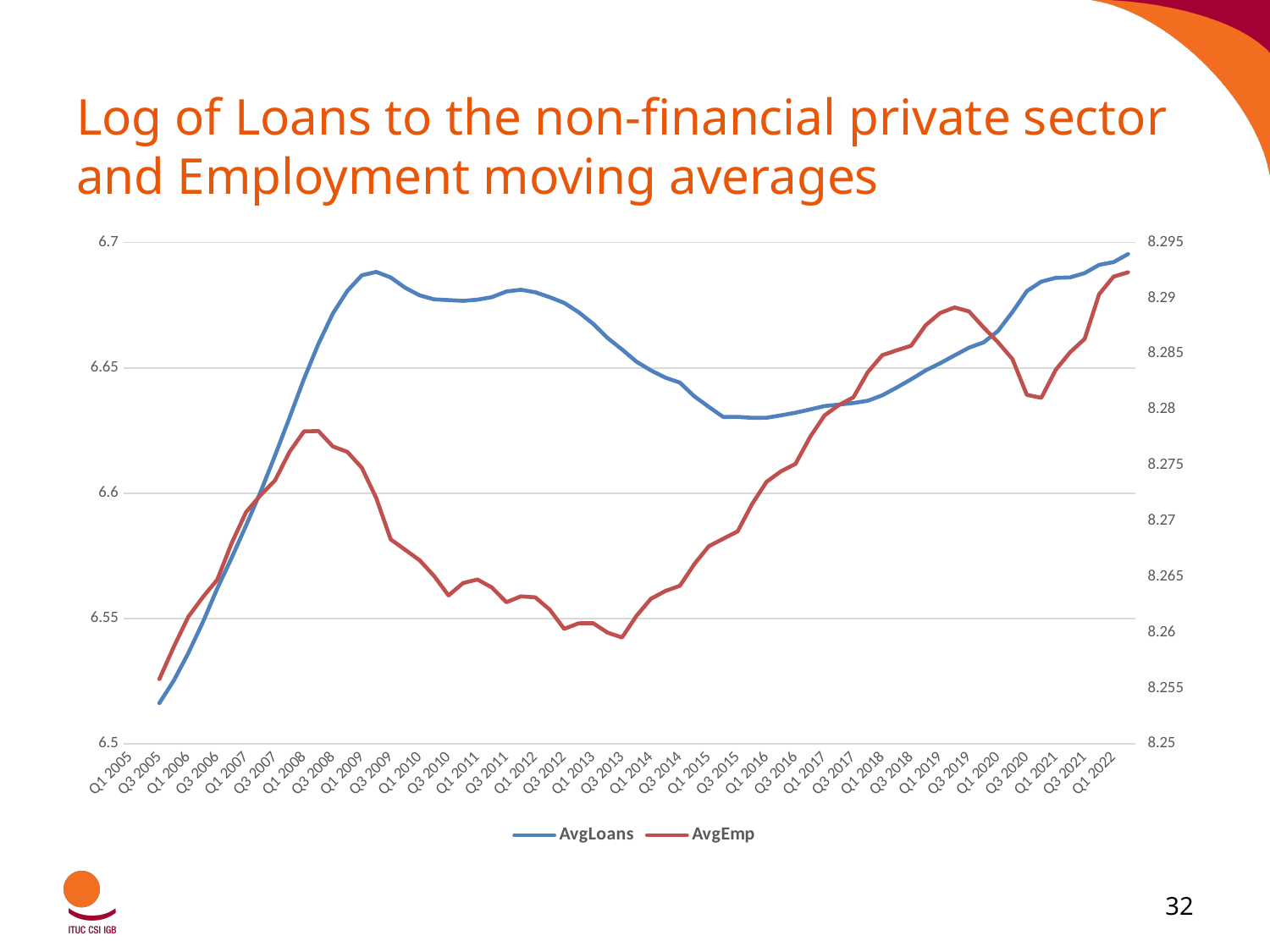
At which quarter is the AvgLoans line at its lowest? Q3 2005 Does the AvgLoans line rise or fall between Q1 2005 and Q1 2009? rise Is the value of AvgEmp at Q3 2019 greater or less than 8.285? greater What kind of chart is shown on the slide? line chart How many series does the legend list? 2 What are the two series named in the legend? AvgLoans and AvgEmp Which colour is used for the AvgEmp line? red Does the AvgEmp line rise or fall between Q1 2008 and Q1 2013? fall Is the value of AvgLoans at Q1 2009 greater or less than 6.65? greater Is the value of AvgLoans at Q1 2016 greater or less than 6.6? greater